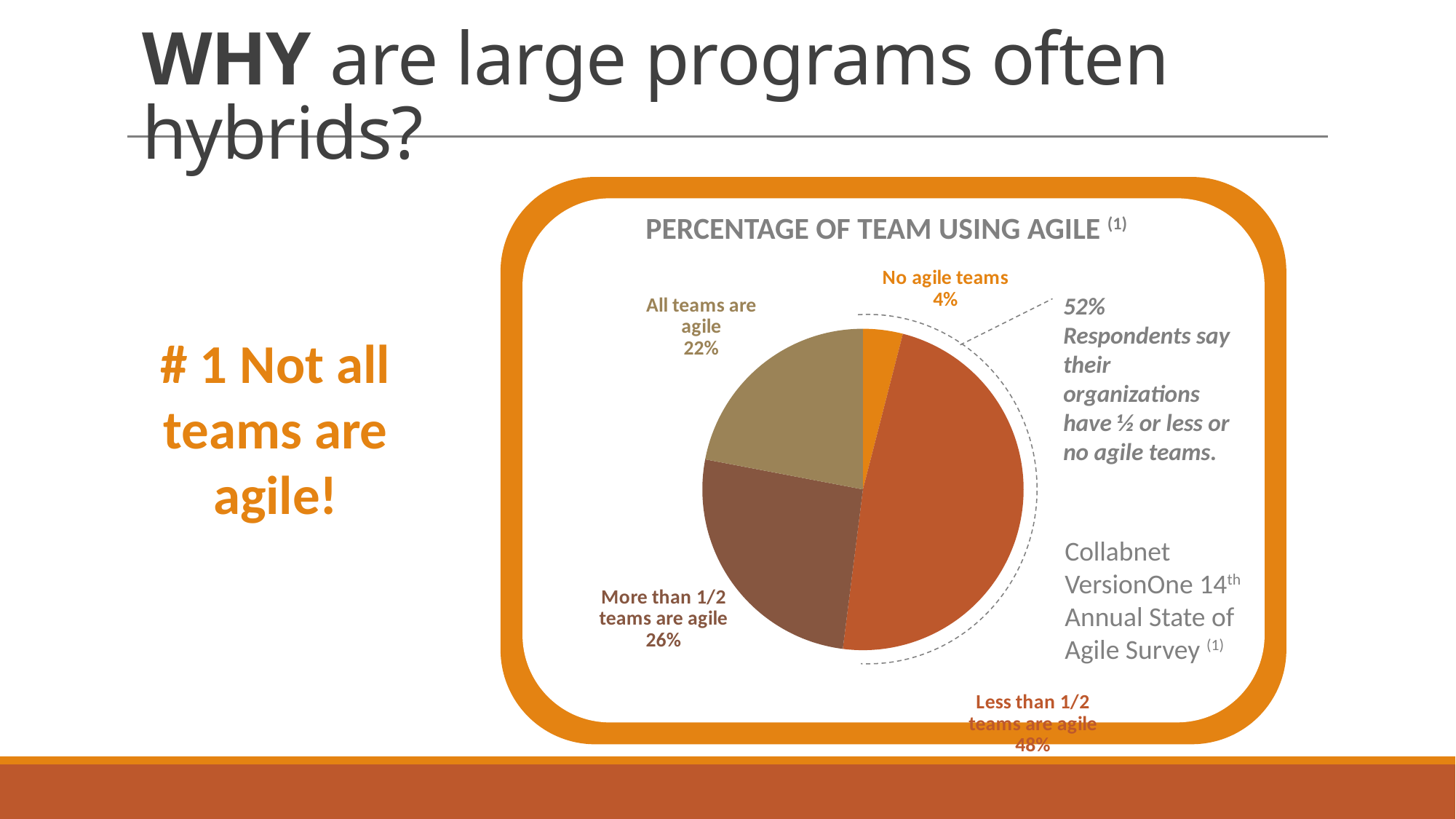
What percentage of respondents have less than 1/2 of teams agile? 48% What percentage of respondents have all teams agile? 22% What percentage of respondents have more than 1/2 of teams agile? 26% Which category has the largest share of the pie? Less than 1/2 teams are agile What type of chart is shown on the slide? pie chart What is the difference between the 'Less than 1/2 teams are agile' share and the 'All teams are agile' share? 26% What percentage of respondents have no agile teams? 4% What is the combined share of 'Less than 1/2 teams are agile' and 'No agile teams'? 52% How many slices does the pie chart have? 4 Which is larger: the share for 'More than 1/2 teams are agile' or 'All teams are agile'? More than 1/2 teams are agile What is the title of the chart? PERCENTAGE OF TEAM USING AGILE Which category has the smallest share of the pie? No agile teams